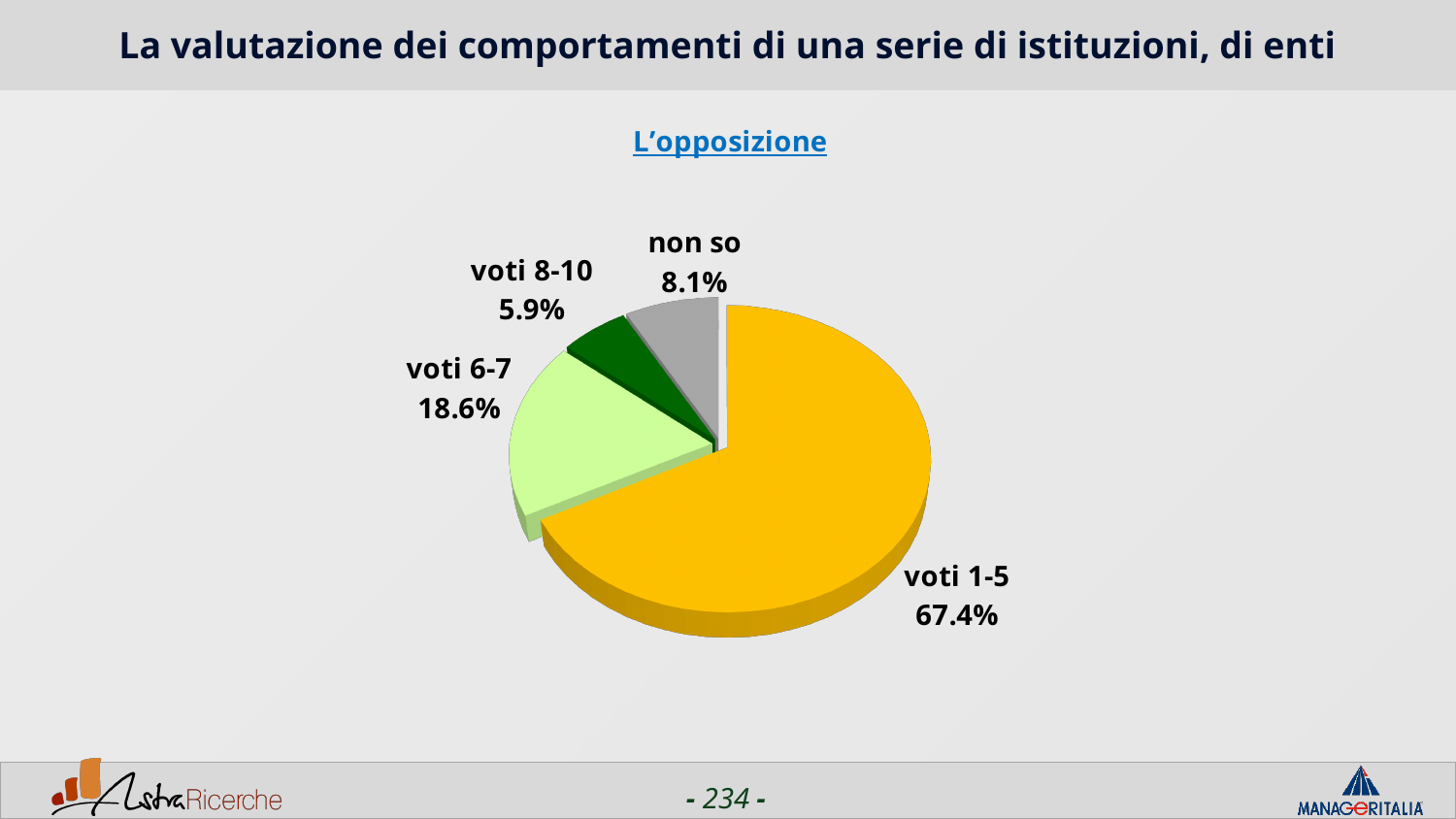
How many slices does the pie chart have? 4 Which slice of the pie is the smallest? voti 8-10 What type of chart is shown on the slide? pie chart What is the difference in percentage points between "voti 1-5" and "voti 6-7"? 48.8 Which is larger, the share for "non so" or the share for "voti 8-10"? non so What share of the pie is labelled "voti 1-5"? 67.4% What share of the pie is labelled "voti 6-7"? 18.6% What is the subtitle of the pie chart? L'opposizione What colour is the "voti 1-5" slice? yellow What share of the pie is labelled "voti 8-10"? 5.9% Which slice of the pie is the largest? voti 1-5 What share of the pie is labelled "non so"? 8.1%